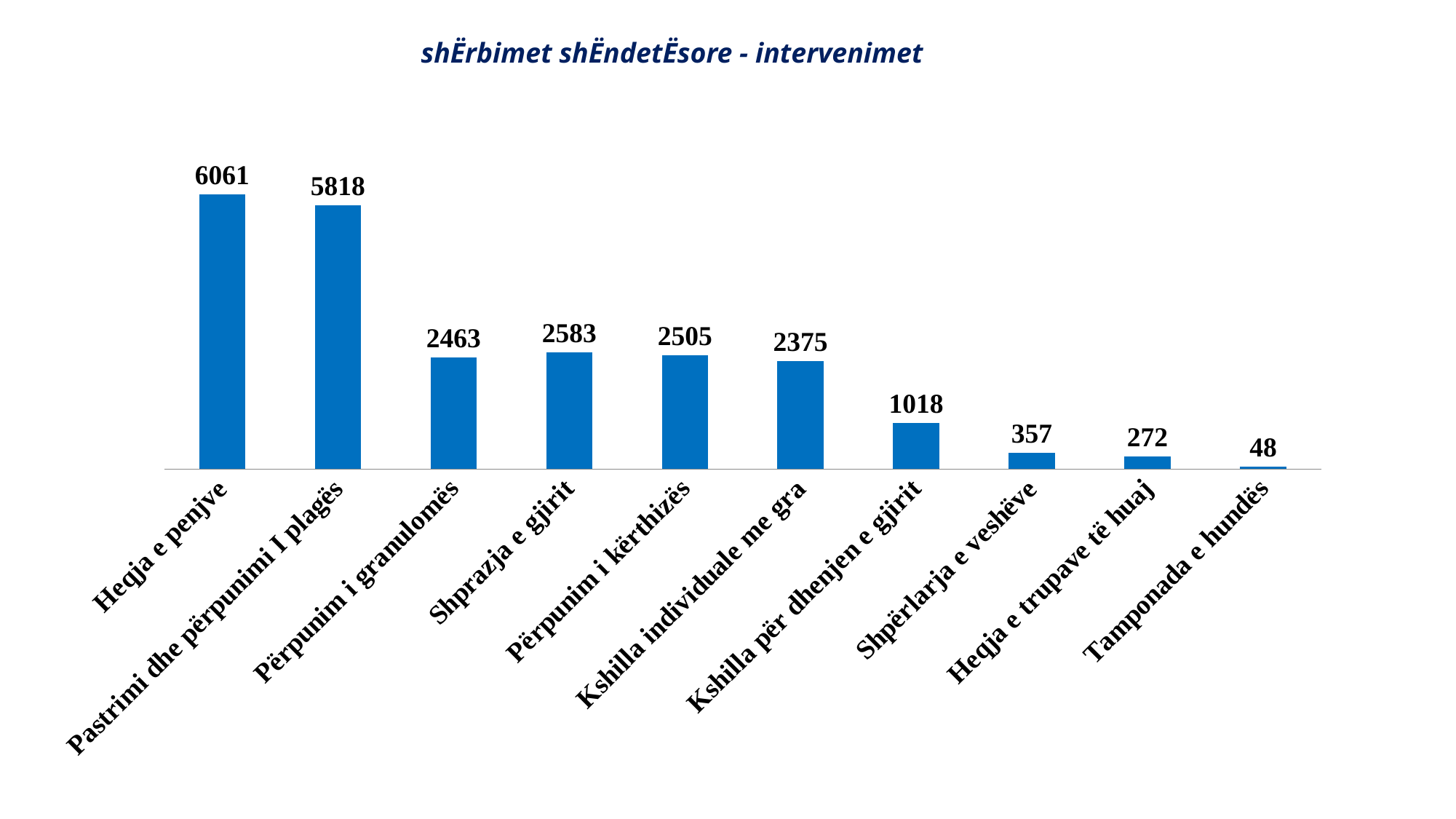
What is the value for Tamponada e hundës? 48 What is the value for Kshilla për dhenjen e gjirit? 1018 What is the title of the chart? shËrbimet shËndetËsore - intervenimet Which category has the lowest value? Tamponada e hundës What is the difference between Shpërlarja e veshëve and Heqja e trupave të huaj? 85 What kind of chart is shown on the slide? Bar chart Which category has the highest value? Heqja e penjve Which is larger, Shprazja e gjirit or Përpunim i kërthizës? Shprazja e gjirit How many categories are shown in the chart? 10 What is the difference between Heqja e penjve and Pastrimi dhe përpunimi I plagës? 243 Do the values generally rise or fall from left to right along the x axis? Fall What is the value for Heqja e penjve? 6061